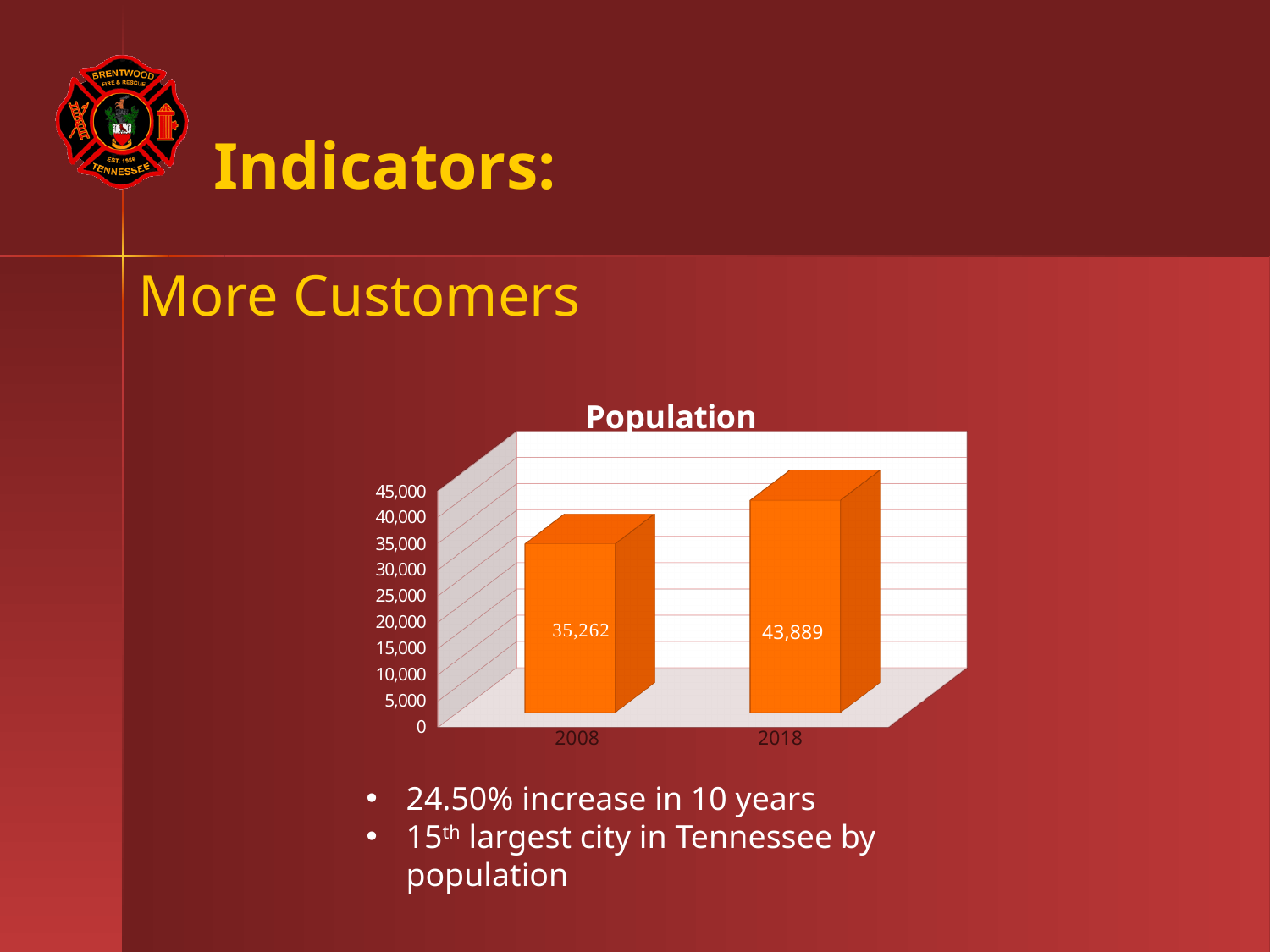
What is the difference between the 2018 and 2008 population values? 8,627 Is the population value for 2018 greater or less than 40,000? greater Is the population value for 2008 greater or less than 40,000? less Is the population for 2018 larger than the population for 2008? Yes What is the title of the chart? Population How many years are shown on the x axis of the chart? 2 What is the population value shown for 2008? 35,262 Does the population rise or fall from 2008 to 2018? Rise Which year has the higher population? 2018 Which year has the lower population? 2008 What is the population value shown for 2018? 43,889 What kind of chart is used to show the population? Bar chart